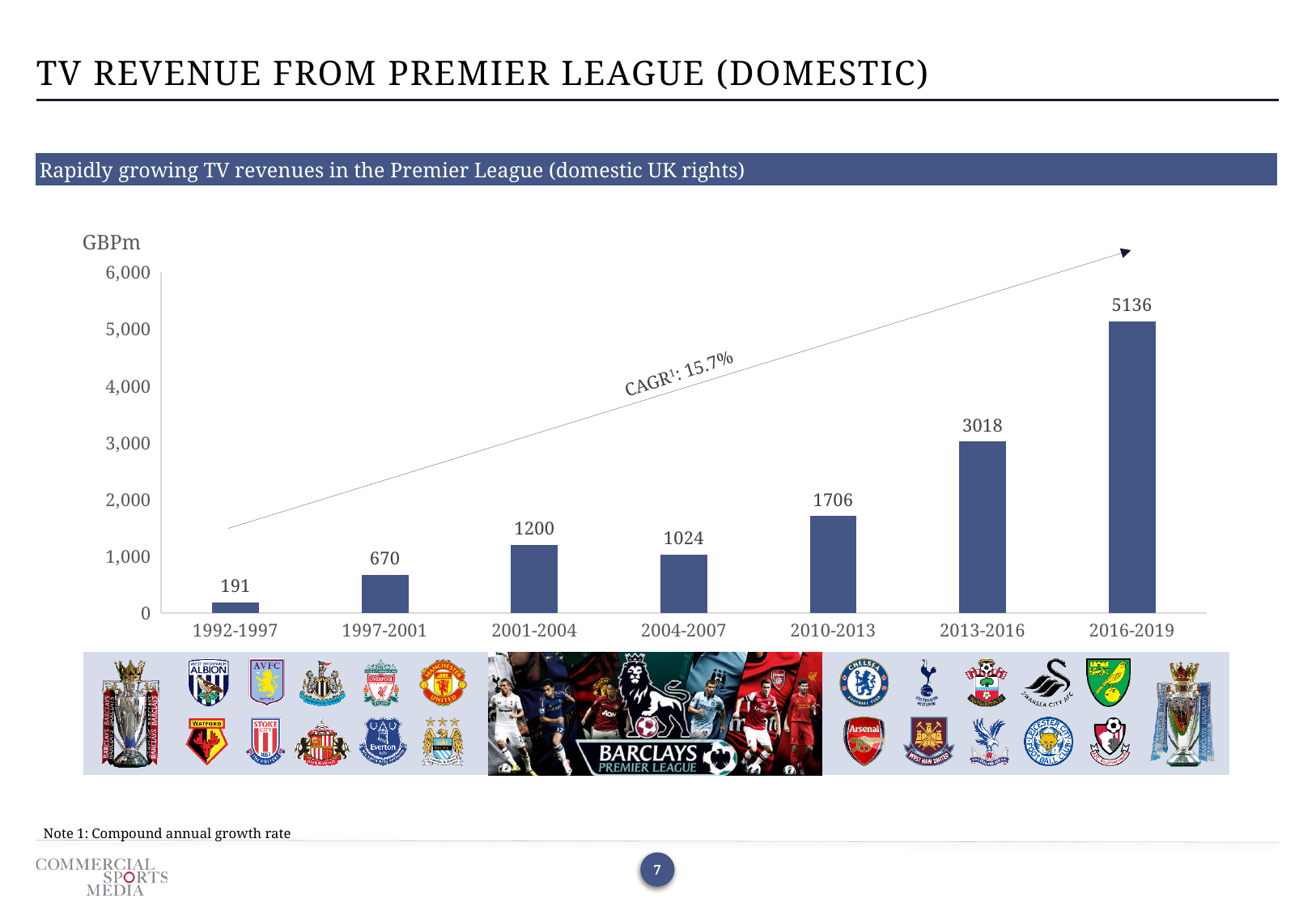
Which period has the highest TV revenue? 2016-2019 What CAGR is annotated on the chart? 15.7% What unit is shown on the y axis of the chart? GBPm Is the value for 2010-2013 greater or less than 2,000? less Which period has the larger TV revenue, 2001-2004 or 2004-2007? 2001-2004 How many periods are shown on the x axis of the chart? 7 What is the TV revenue value for the 2016-2019 period? 5136 What is the TV revenue value for the 1992-1997 period? 191 What is the TV revenue value for the 2004-2007 period? 1024 Which period has the lowest TV revenue? 1992-1997 What kind of chart is shown on the slide? bar chart What is the difference in TV revenue between 2016-2019 and 2013-2016? 2118